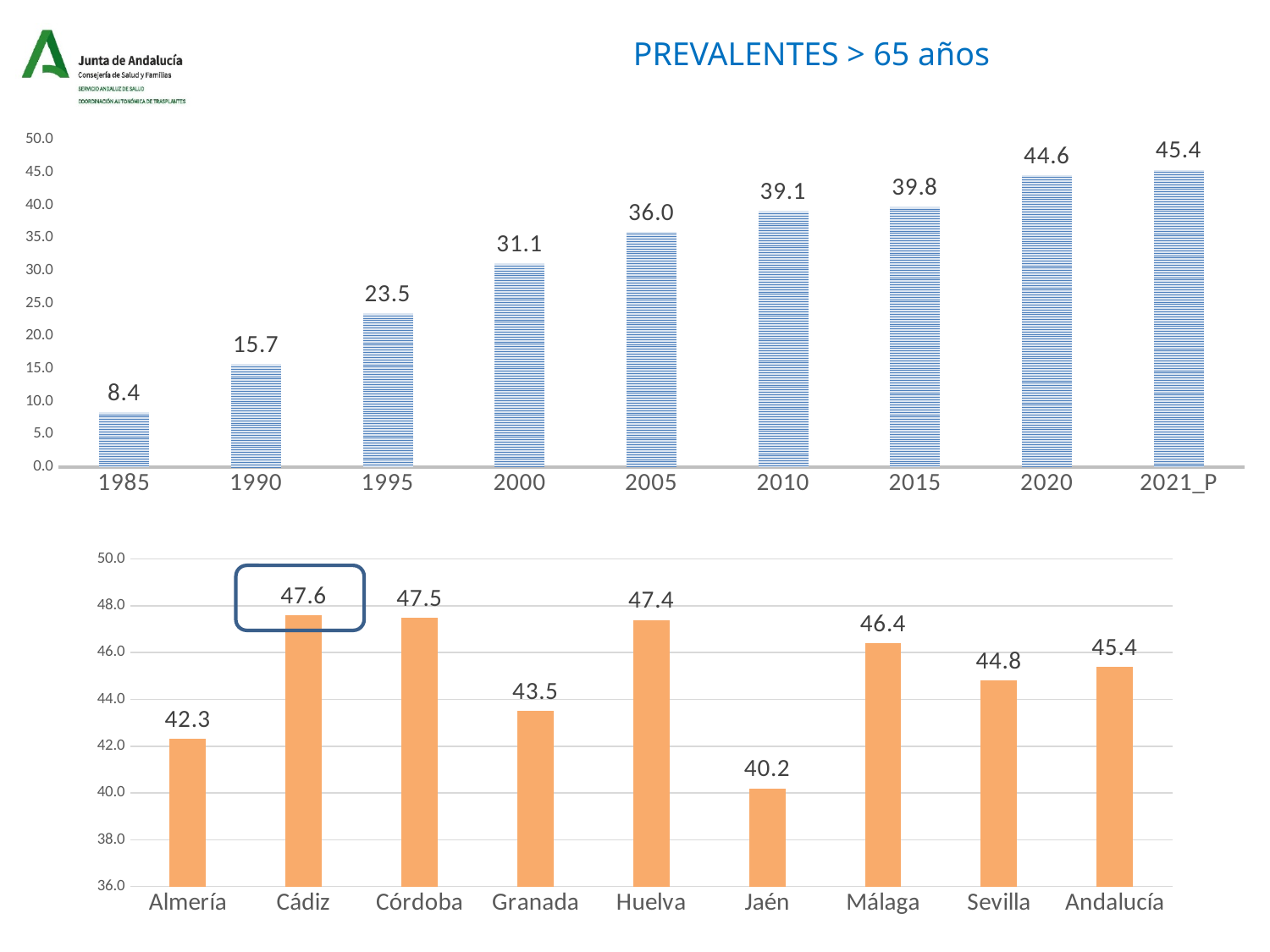
In the bottom chart (by province), which is larger, the value for Granada or the value for Málaga? Málaga In the top chart (by year), how many bars are plotted? 9 In the top chart (by year), do the values rise or fall from 1985 to 2021_P? rise What is the title shown at the top of the slide? PREVALENTES > 65 años What kind of chart is the bottom chart (by province)? bar chart In the top chart (by year), what is the value for 2021_P? 45.4 In the top chart (by year), what is the difference between the values for 2020 and 2015? 4.8 In the bottom chart (by province), which province has the lowest value? Jaén In the top chart (by year), which year has the lowest value? 1985 In the top chart (by year), what is the value for 1985? 8.4 In the bottom chart (by province), what is the difference between the values for Cádiz and Almería? 5.3 In the bottom chart (by province), what is the value for Jaén? 40.2